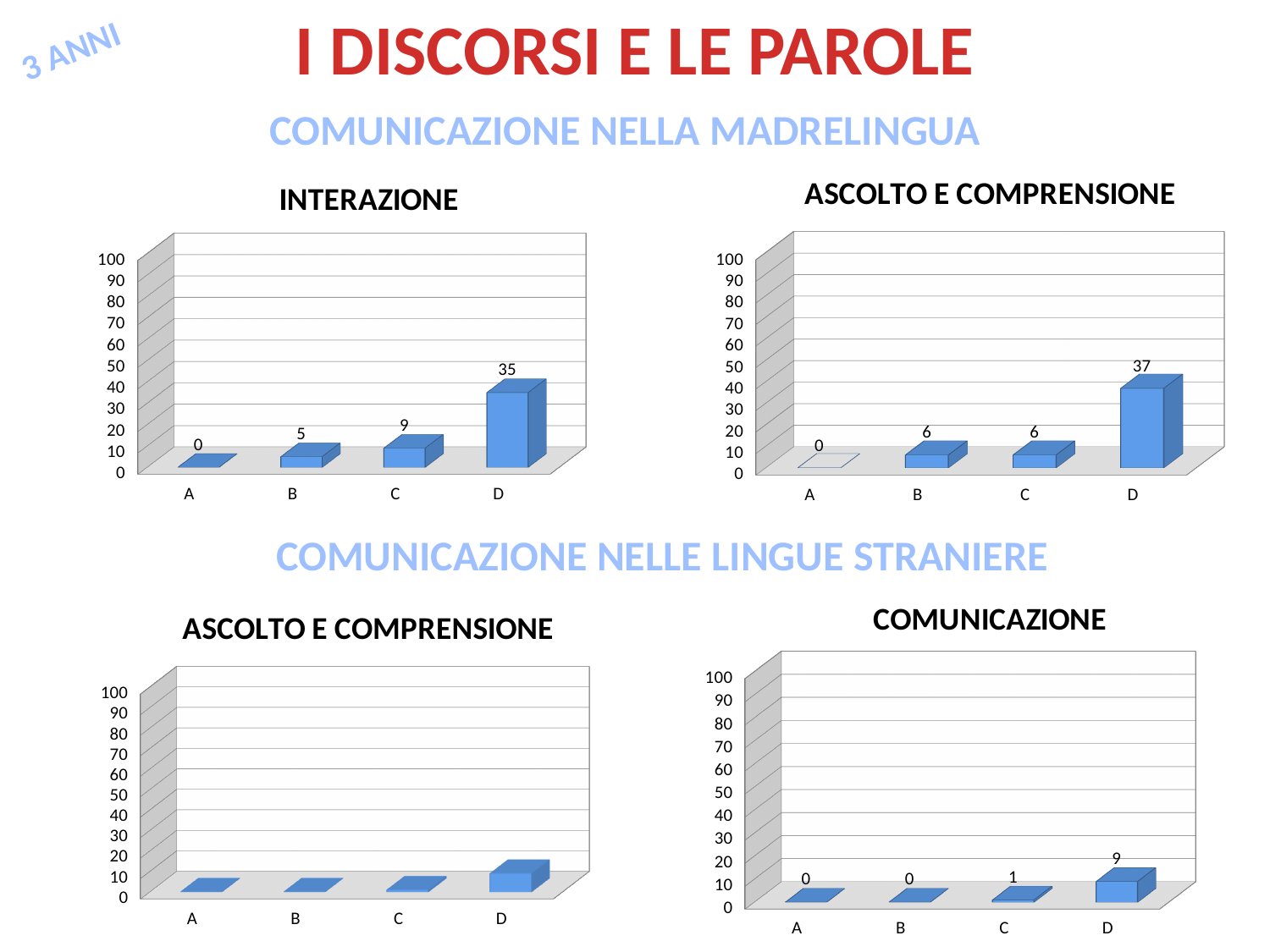
In the INTERAZIONE chart, what is the value for B? 5 In the INTERAZIONE chart, what is the value for D? 35 In the top-right ASCOLTO E COMPRENSIONE chart (under COMUNICAZIONE NELLA MADRELINGUA), what is the value for B? 6 In the top-right ASCOLTO E COMPRENSIONE chart (under COMUNICAZIONE NELLA MADRELINGUA), how many categories are shown on the x axis? 4 In the INTERAZIONE chart, which category has the highest value? D In the INTERAZIONE chart, what is the difference between the values for D and C? 26 In the bottom-right COMUNICAZIONE chart, which is larger, the value for C or the value for D? D What kind of chart is the INTERAZIONE chart? bar chart In the bottom-left ASCOLTO E COMPRENSIONE chart (under COMUNICAZIONE NELLE LINGUE STRANIERE), is the value for D greater or less than 50? less In the bottom-right COMUNICAZIONE chart, what is the value for C? 1 In the top-right ASCOLTO E COMPRENSIONE chart (under COMUNICAZIONE NELLA MADRELINGUA), what is the value for D? 37 In the bottom-right COMUNICAZIONE chart, what is the value for D? 9